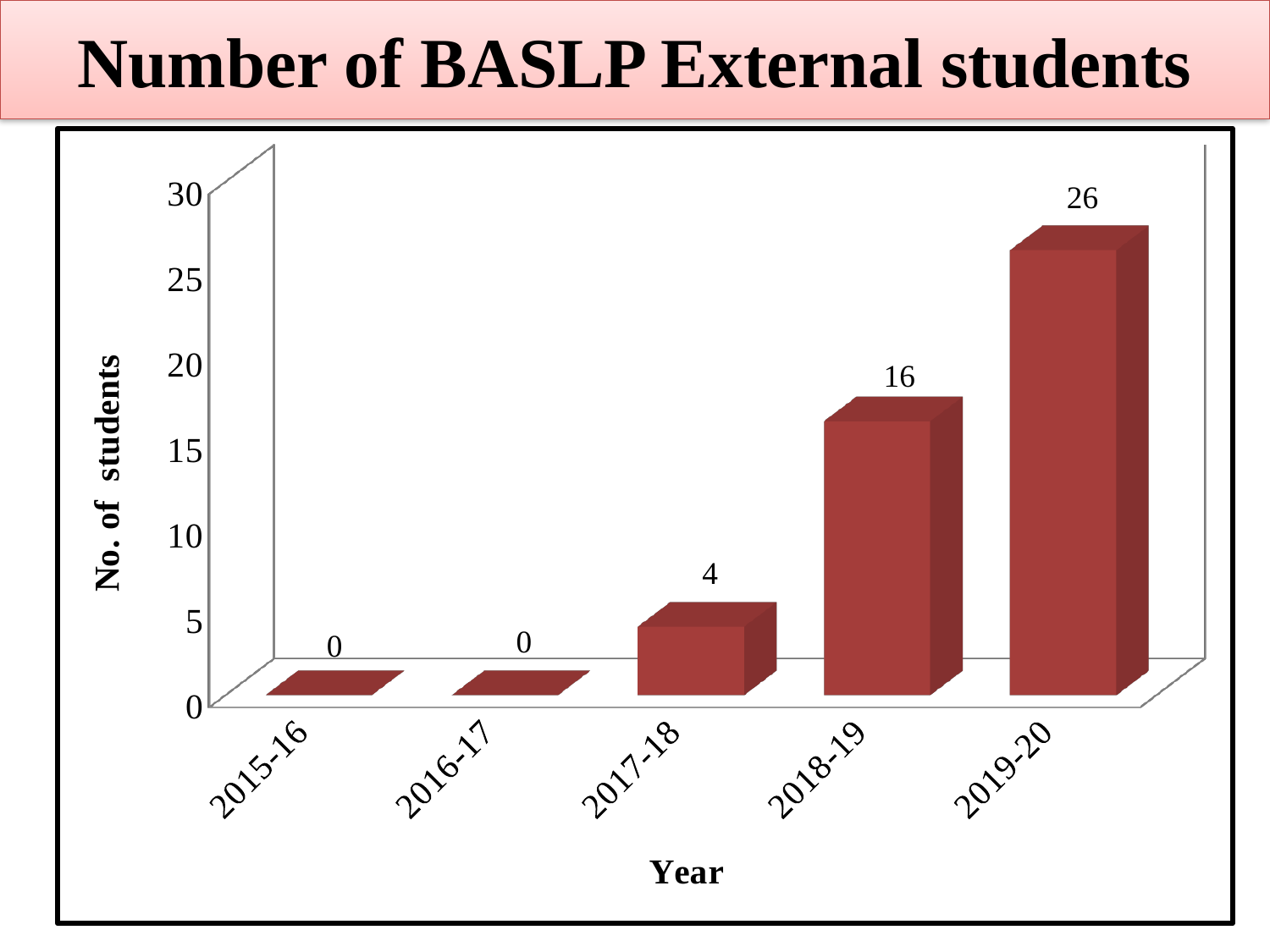
Which year has the highest number of BASLP external students? 2019-20 Do the values rise or fall from 2015-16 to 2019-20? Rise What is the difference in the number of students between 2019-20 and 2018-19? 10 What kind of chart is shown on the slide? Bar chart What is the number of BASLP external students in 2015-16? 0 What is the number of BASLP external students in 2017-18? 4 What is the number of BASLP external students in 2018-19? 16 How many years are shown on the x axis of the chart? 5 What is the label of the vertical axis of the chart? No. of students What is the number of BASLP external students in 2019-20? 26 Which year has more students, 2017-18 or 2018-19? 2018-19 What is the difference in the number of students between 2018-19 and 2017-18? 12